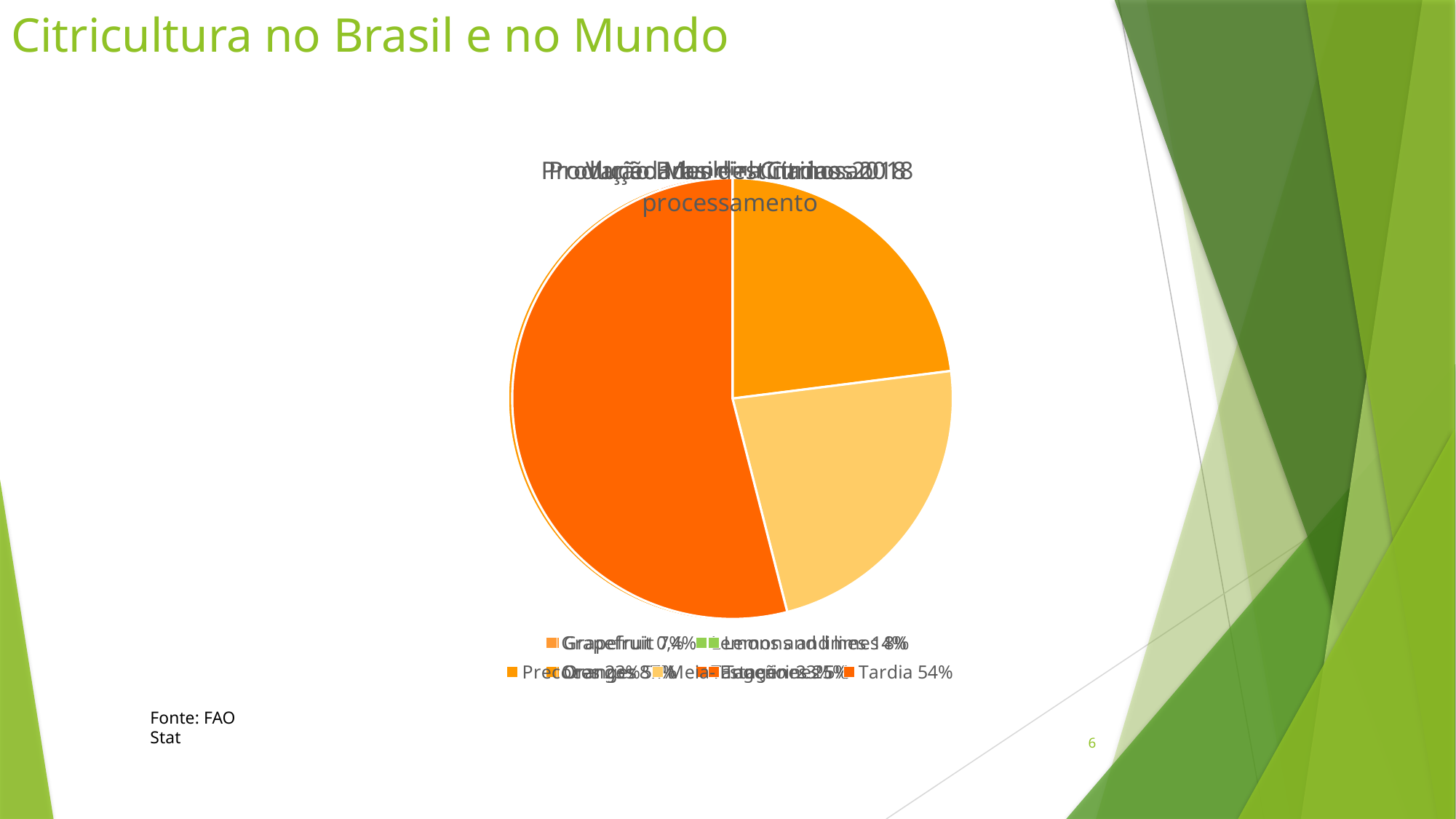
What is the difference between the Tardia share and the Meia Estação share in the visible pie chart? 31% Which is larger in the visible pie chart, Tardia or Meia Estação? Tardia What share of the visible pie chart does Tardia represent, according to the legend? 54% Which slice of the visible pie chart is the largest? Tardia How many slices does the visible pie chart have? 3 What is the source cited at the bottom of the slide? FAO Stat What kind of chart is shown on the slide? pie chart What share of the visible pie chart does Meia Estação represent, according to the legend? 23%